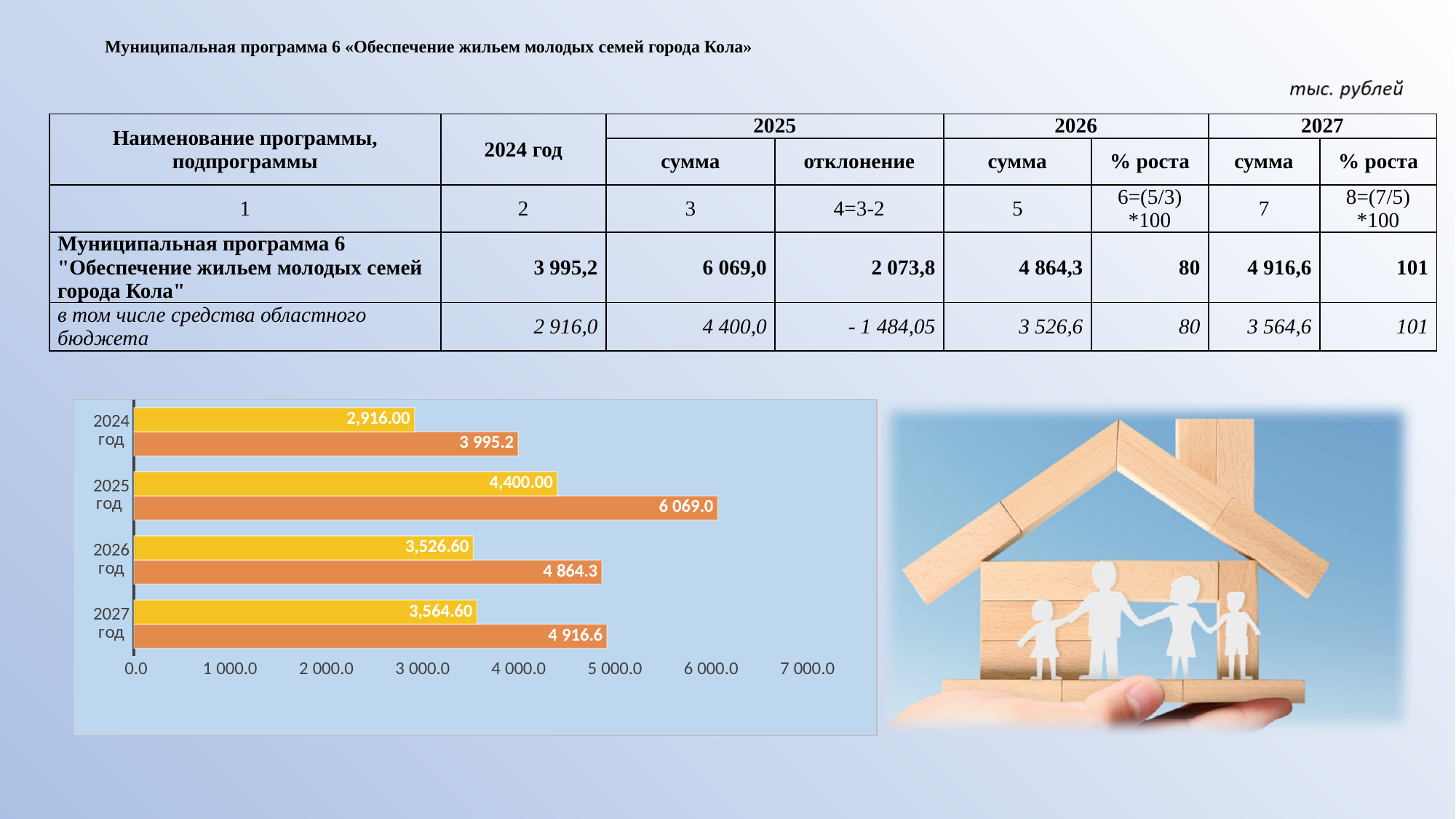
Which year has the lowest yellow bar? 2024 год Which year has the highest orange bar? 2025 год What is the difference between the orange bar for 2025 год and the orange bar for 2024 год? 2 073.8 How many year categories are shown on the chart? 4 What is the value of the orange bar for 2025 год? 6 069.0 What is the value of the yellow bar for 2026 год? 3,526.60 Is the orange bar for 2025 год greater or less than 5 000.0? greater Which is larger: the yellow bar for 2025 год or the yellow bar for 2026 год? 2025 год What is the value of the yellow bar for 2024 год? 2,916.00 What is the largest tick value shown on the horizontal axis of the chart? 7 000.0 What kind of chart is shown on the slide? bar chart Is the yellow bar for 2027 год greater or less than 4 000.0? less